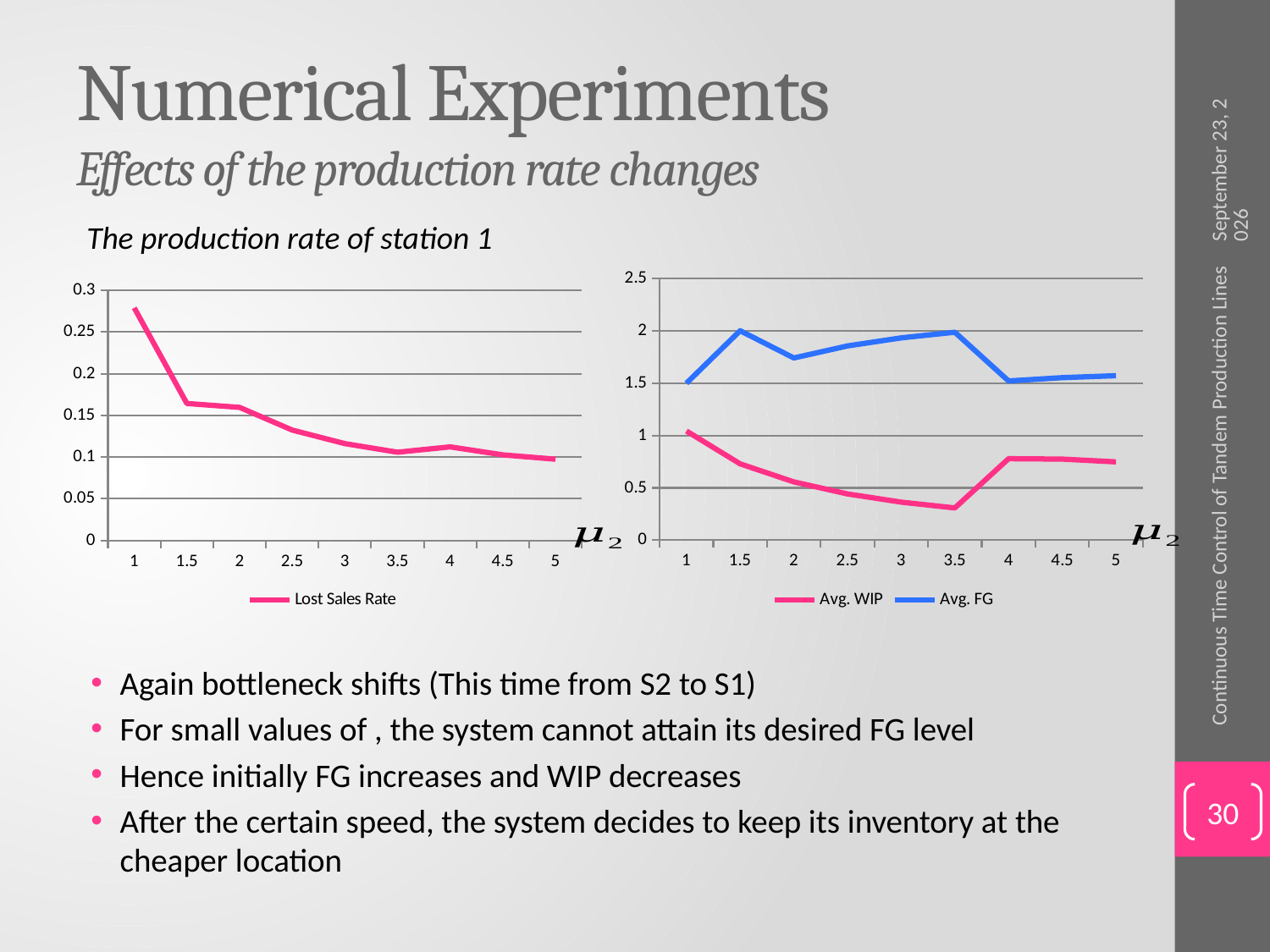
On the right chart, at x = 3, which series has the larger value, Avg. WIP or Avg. FG? Avg. FG On the right chart, is the Avg. WIP value at x = 3.5 greater or less than 0.5? less On the left chart, at which x-axis value is the Lost Sales Rate highest? 1 How many series does the legend of the right chart list? 2 On the right chart, at which x-axis value is Avg. WIP lowest? 3.5 How many x-axis points are plotted on the left chart (Lost Sales Rate)? 9 On the left chart, is the Lost Sales Rate at x = 3 greater or less than 0.15? less On the right chart, is the Avg. FG value at x = 4 greater or less than 1? greater What kind of chart is the left chart (Lost Sales Rate)? line chart On the left chart, does the Lost Sales Rate generally rise or fall as the x-axis value increases from 1 to 5? fall What are the two series named in the legend of the right chart? Avg. WIP and Avg. FG